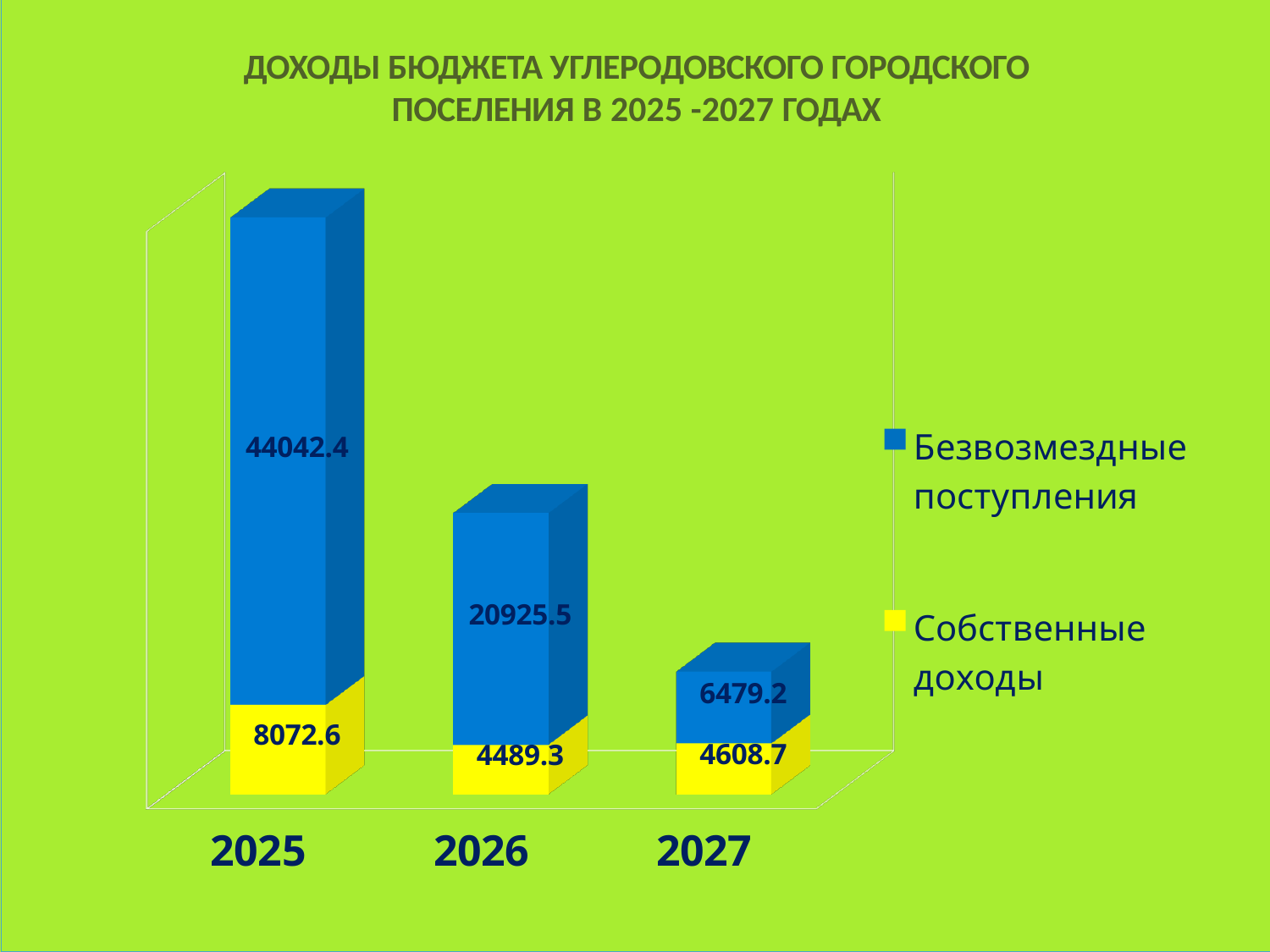
Which is larger: Собственные доходы in 2026 or in 2027? 2027 Which year has the highest value of Безвозмездные поступления? 2025 What is the value of Безвозмездные поступления for 2027? 6479.2 What is the total of the stacked bar for 2027? 11087.9 How many years are shown on the x axis? 3 What kind of chart is shown on the slide? Stacked bar chart What is the value of Безвозмездные поступления for 2025? 44042.4 How many series does the legend list? 2 What is the difference between Безвозмездные поступления in 2025 and 2026? 23116.9 Which year has the lowest value of Собственные доходы? 2026 What is the value of Собственные доходы for 2026? 4489.3 What is the difference between Собственные доходы in 2025 and 2026? 3583.3